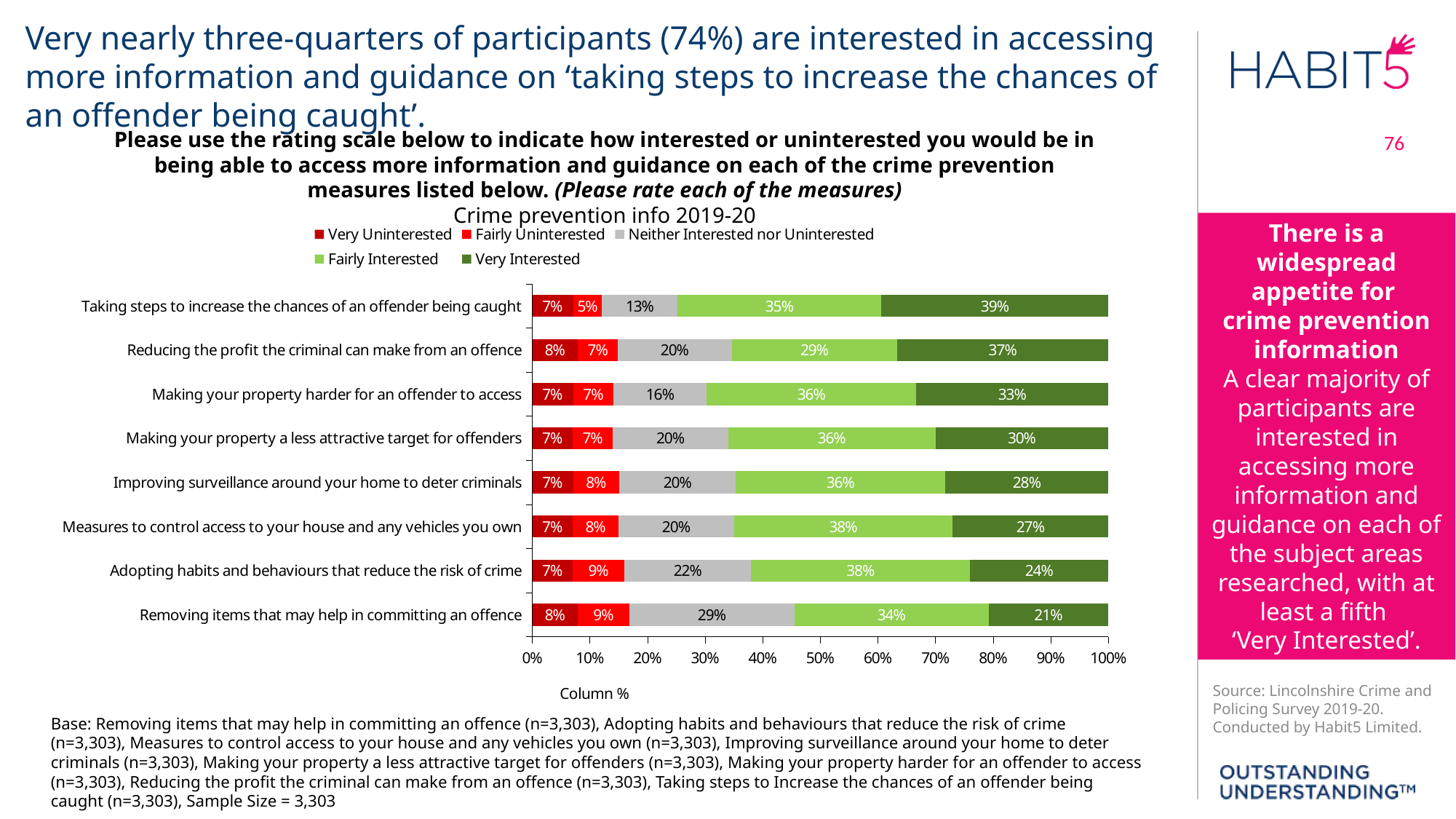
What percentage of participants are 'Very Interested' in 'Taking steps to increase the chances of an offender being caught'? 39% How many rating categories does the chart legend list? 5 Which measure has the highest 'Very Interested' percentage? Taking steps to increase the chances of an offender being caught How many crime prevention measures are shown in the chart? 8 Which measure has the lowest 'Very Interested' percentage? Removing items that may help in committing an offence What is the 'Fairly Interested' value for 'Reducing the profit the criminal can make from an offence'? 29% What is the title of the chart? Crime prevention info 2019-20 What is the difference in 'Very Interested' percentage between 'Taking steps to increase the chances of an offender being caught' and 'Removing items that may help in committing an offence'? 18 percentage points What is the combined 'Fairly Interested' and 'Very Interested' percentage for 'Taking steps to increase the chances of an offender being caught'? 74% What type of chart is shown on the slide? Stacked bar chart What is the 'Neither Interested nor Uninterested' value for 'Removing items that may help in committing an offence'? 29% Which has a larger 'Fairly Interested' share: 'Adopting habits and behaviours that reduce the risk of crime' or 'Removing items that may help in committing an offence'? Adopting habits and behaviours that reduce the risk of crime